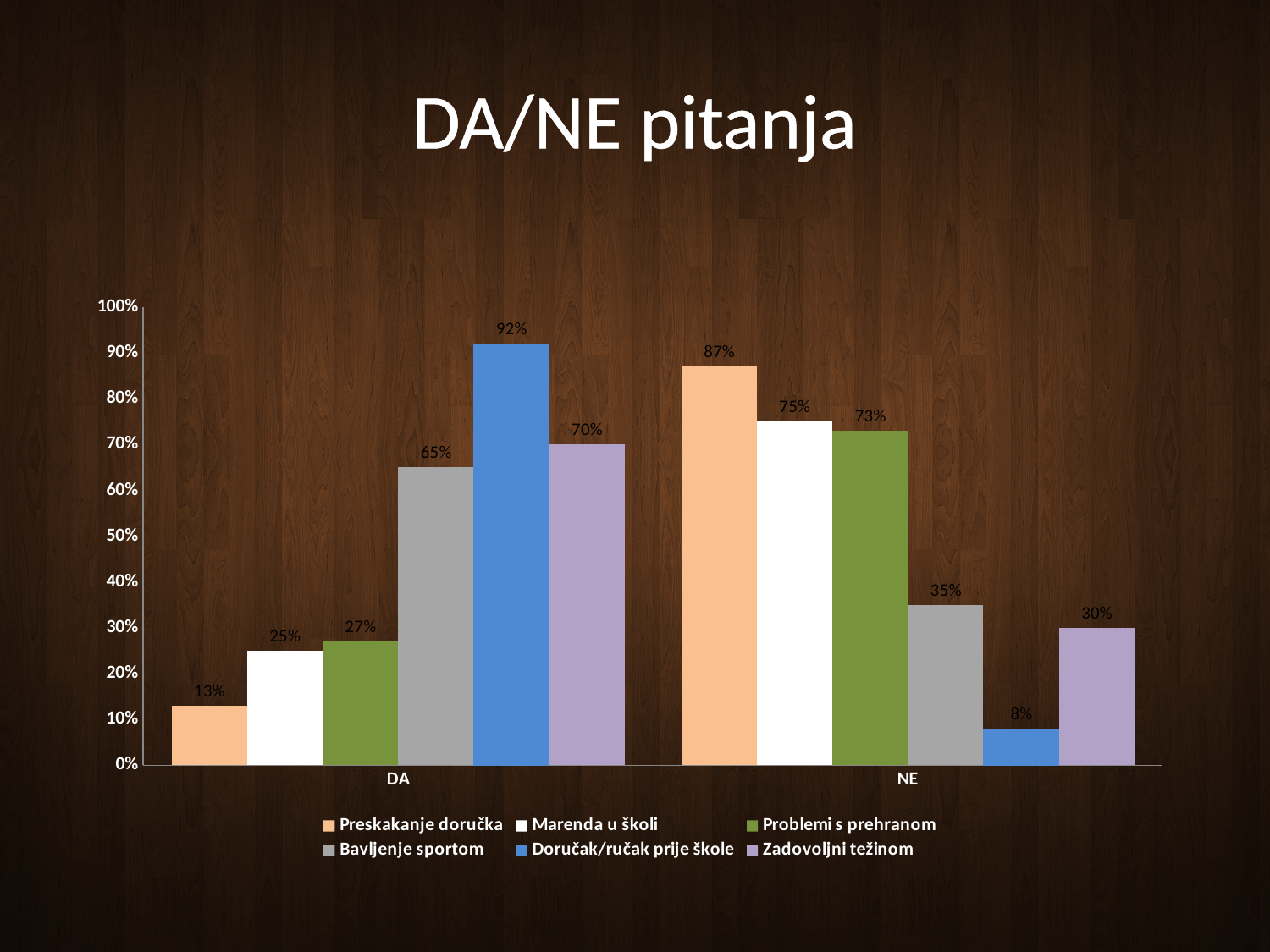
Which is larger: the DA value for Problemi s prehranom or the DA value for Marenda u školi? Problemi s prehranom What is the value for Doručak/ručak prije škole in the DA category? 92% Which series has the highest value in the DA category? Doručak/ručak prije škole What is the difference between the NE and DA values for Marenda u školi? 50% What is the value for Bavljenje sportom in the DA category? 65% What kind of chart is shown on the slide? Bar chart How many categories are shown on the x axis? 2 What is the value for Preskakanje doručka in the NE category? 87% What is the value for Zadovoljni težinom in the NE category? 30% Which series has the lowest value in the NE category? Doručak/ručak prije škole What is the title of the slide? DA/NE pitanja How many series does the legend list? 6